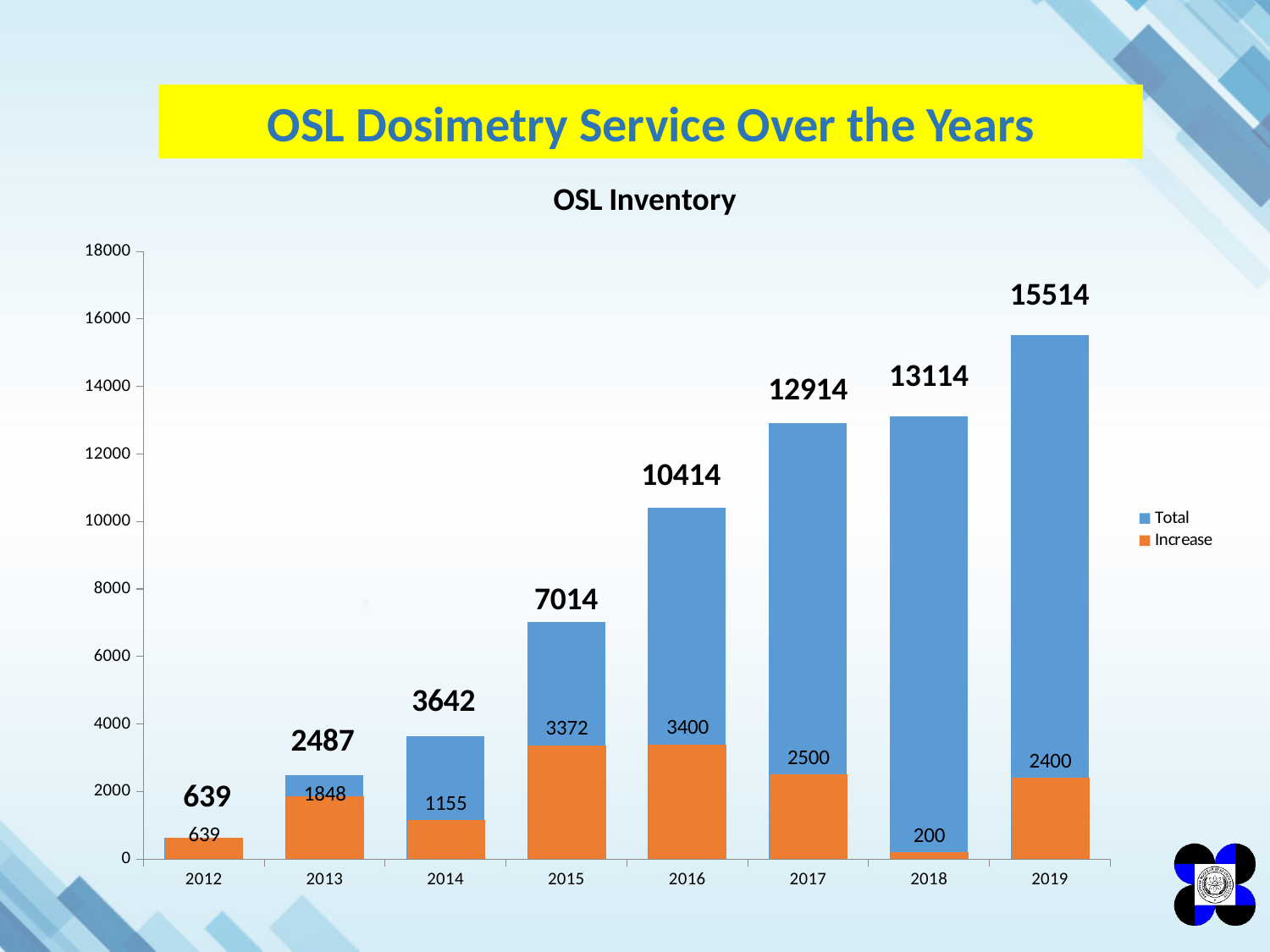
Which year has the highest Total value? 2019 What is the Total value for 2019? 15514 What is the difference between the Total values for 2018 and 2017? 200 How many years are shown on the x axis? 8 Which is larger, the Increase value for 2016 or the Increase value for 2017? 2016 What is the Increase value for 2015? 3372 How many series does the legend list? 2 Is the Total value for 2017 greater or less than 12000? greater Which year has the lowest Increase value? 2018 What is the Increase value for 2018? 200 What is the Total value for 2016? 10414 Does the Total value rise or fall from 2012 to 2019? rise